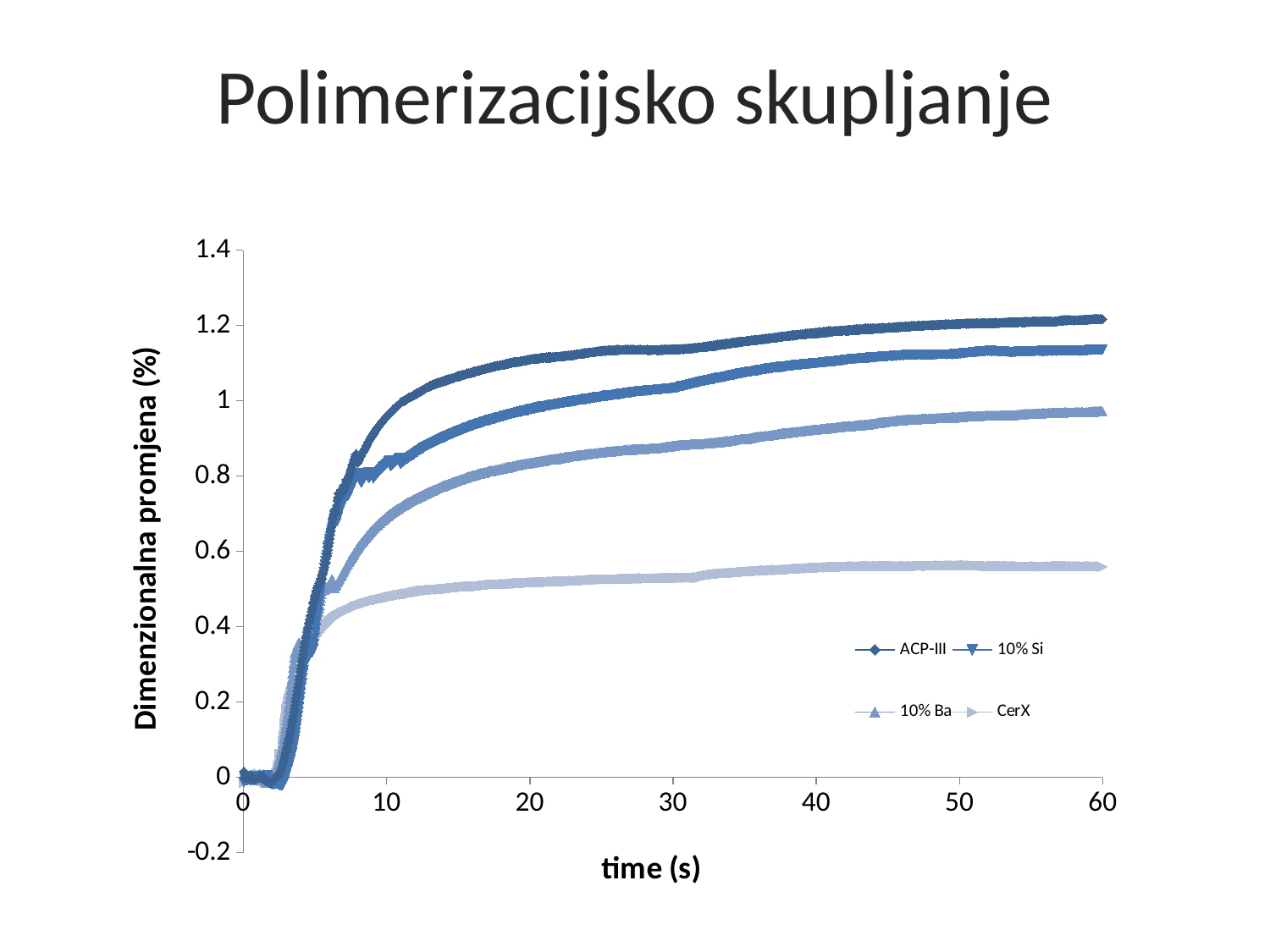
Which series has the highest dimensional change at 60 s? ACP-III What is the title of the slide above the chart? Polimerizacijsko skupljanje Which series has the lowest dimensional change at 60 s? CerX Is the value for 10% Ba at 60 s greater or less than 0.8? greater Is the value for 10% Si at 60 s greater or less than 1? greater What kind of chart is shown on the slide? line chart What is the label of the x axis? time (s) At 60 s, which is larger: the value for 10% Si or the value for 10% Ba? 10% Si Is the value for ACP-III at 60 s greater or less than 1? greater How many series does the legend list? 4 Do the values for ACP-III rise or fall as time increases from 0 to 60 s? rise